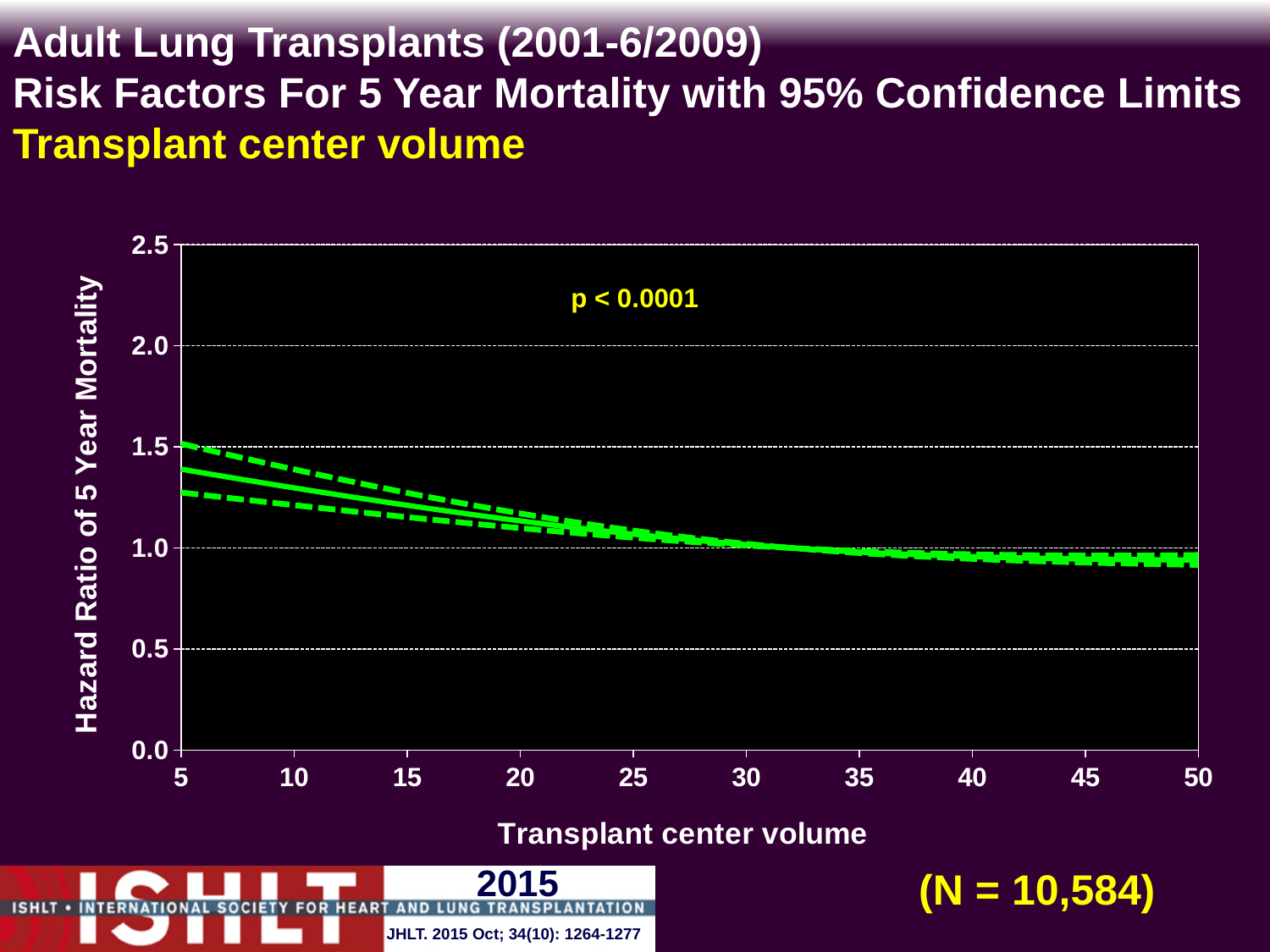
Is the hazard ratio of 5 year mortality (solid line) at a transplant center volume of 5 greater or less than 1.5? less Is the hazard ratio of 5 year mortality higher at a transplant center volume of 5 or at a volume of 30? 5 What is the label of the y axis of the chart? Hazard Ratio of 5 Year Mortality What p-value is printed on the chart? p < 0.0001 How many tick labels are shown on the x axis of the chart? 10 What kind of chart is shown on the slide? line chart Does the hazard ratio of 5 year mortality rise or fall as transplant center volume increases from 5 to 50? fall Is the hazard ratio of 5 year mortality at a transplant center volume of 40 greater or less than 1.5? less Is the hazard ratio of 5 year mortality at a transplant center volume of 10 greater or less than 1.0? greater